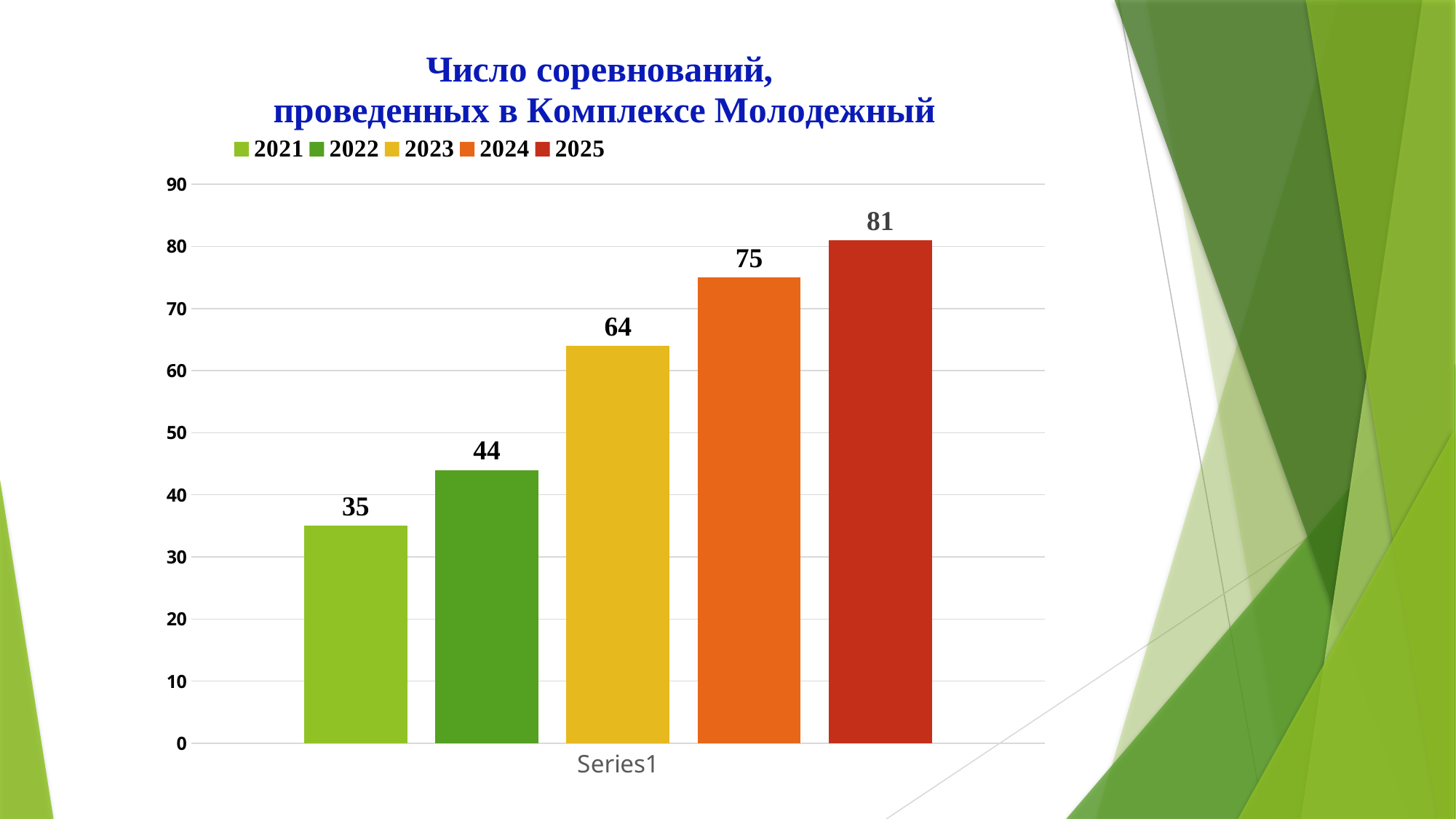
What is the value for 2025? 81 What is the difference between the values for 2025 and 2021? 46 Is the value for 2022 greater or less than 50? less Which year has the highest value? 2025 How many series does the legend list? 5 What is the value for 2023? 64 Which is larger, the value for 2022 or the value for 2024? 2024 What is the difference between the values for 2024 and 2023? 11 Which year has the lowest value? 2021 What is the value for 2021? 35 Do the values rise or fall from 2021 to 2025? rise What kind of chart is shown on the slide? bar chart